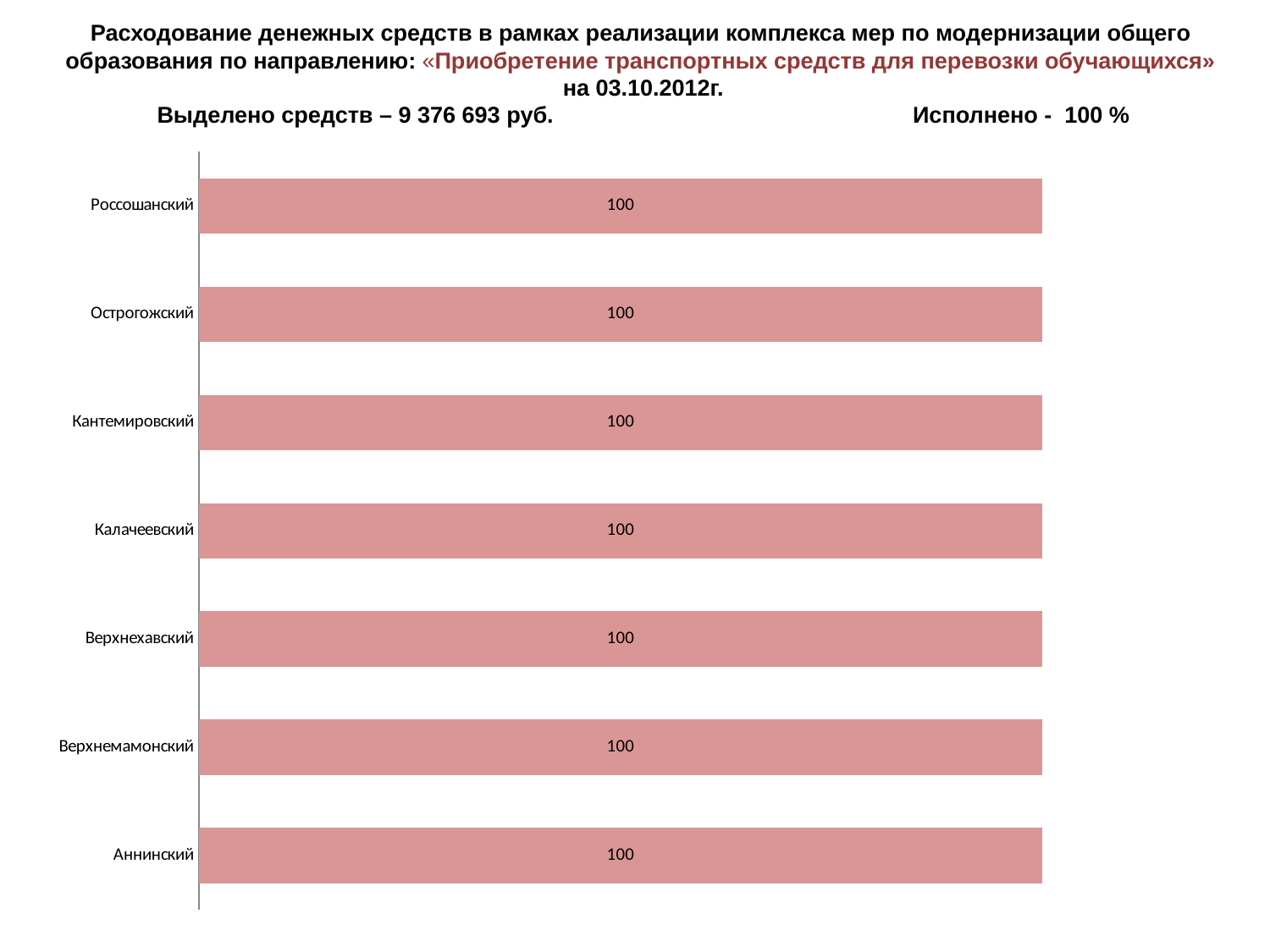
What is the value shown for Верхнемамонский? 100 What kind of chart is shown on the slide? Bar chart What date is given in the slide title? 03.10.2012г. What is the value shown for Кантемировский? 100 Which category is listed at the bottom of the chart? Аннинский What is the value shown for Аннинский? 100 What is the value shown for Калачеевский? 100 What is the value shown for Россошанский? 100 What is the value shown for Острогожский? 100 What is the value shown for Верхнехавский? 100 How many categories (districts) are plotted on the chart? 7 What is the difference between the values for Россошанский and Аннинский? 0